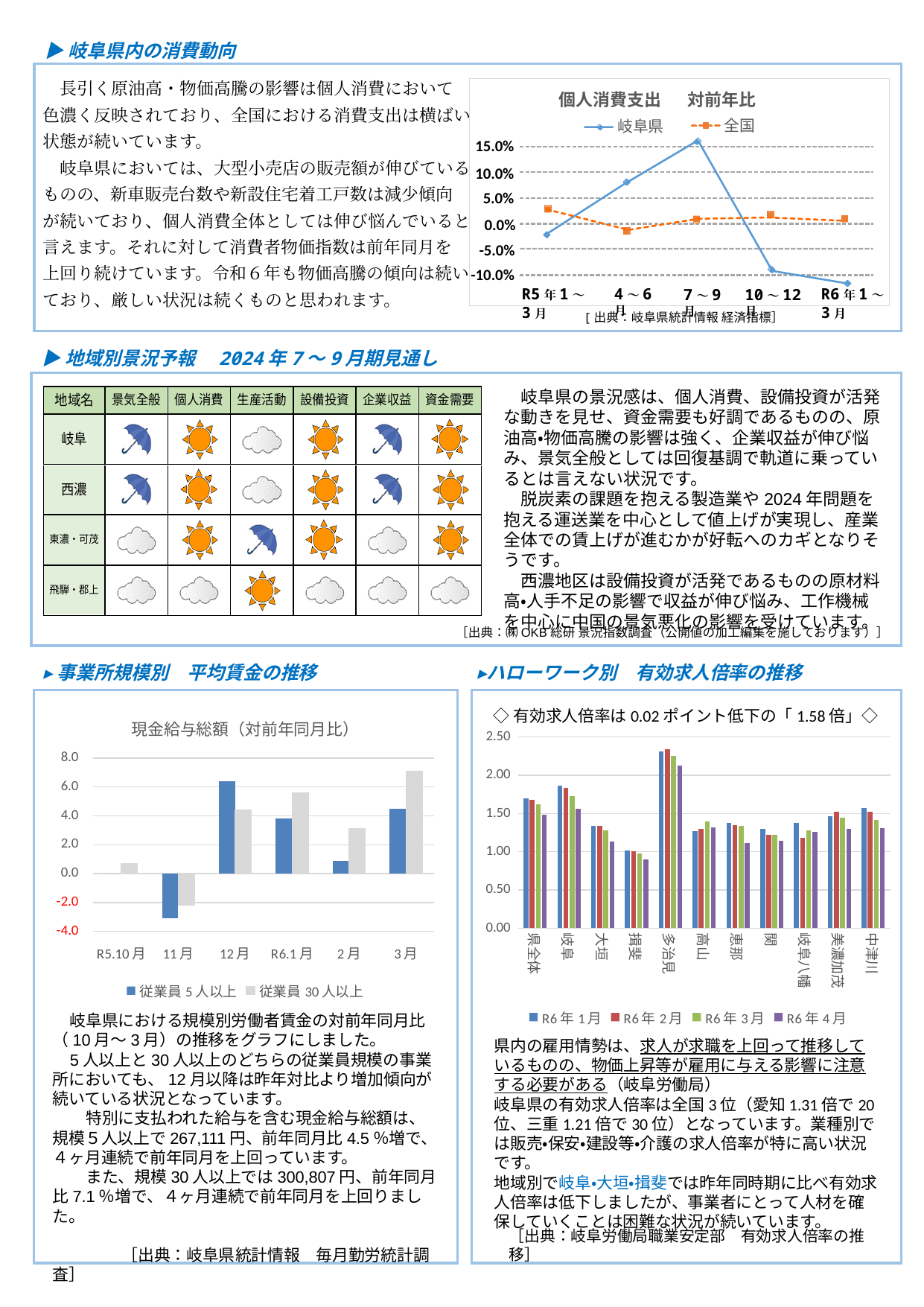
In the 個人消費支出 対前年比 chart, is the 岐阜県 value for 7～9月 greater or less than 10.0%? greater What kind of chart is the 個人消費支出 対前年比 chart at the top of the slide? line chart How many series does the legend of the ハローワーク別 有効求人倍率 chart at the bottom right list? 4 In the ハローワーク別 有効求人倍率 chart, which area has the highest values? 多治見 In the 個人消費支出 対前年比 chart, which period has the highest value for 岐阜県? 7～9月 How many series does the legend of the 個人消費支出 対前年比 chart list? 2 In the 現金給与総額（対前年同月比） chart, which month has the highest value for 従業員5人以上? 12月 How many months are shown on the x axis of the 現金給与総額（対前年同月比） chart? 6 What kind of chart is the 現金給与総額（対前年同月比） chart at the bottom left? bar chart In the 現金給与総額（対前年同月比） chart, is the 従業員30人以上 value for 3月 greater or less than 6.0? greater In the 個人消費支出 対前年比 chart, is the 岐阜県 value for R6年1～3月 greater or less than -10.0%? less In the 現金給与総額（対前年同月比） chart, which month has the lowest value for 従業員30人以上? 11月